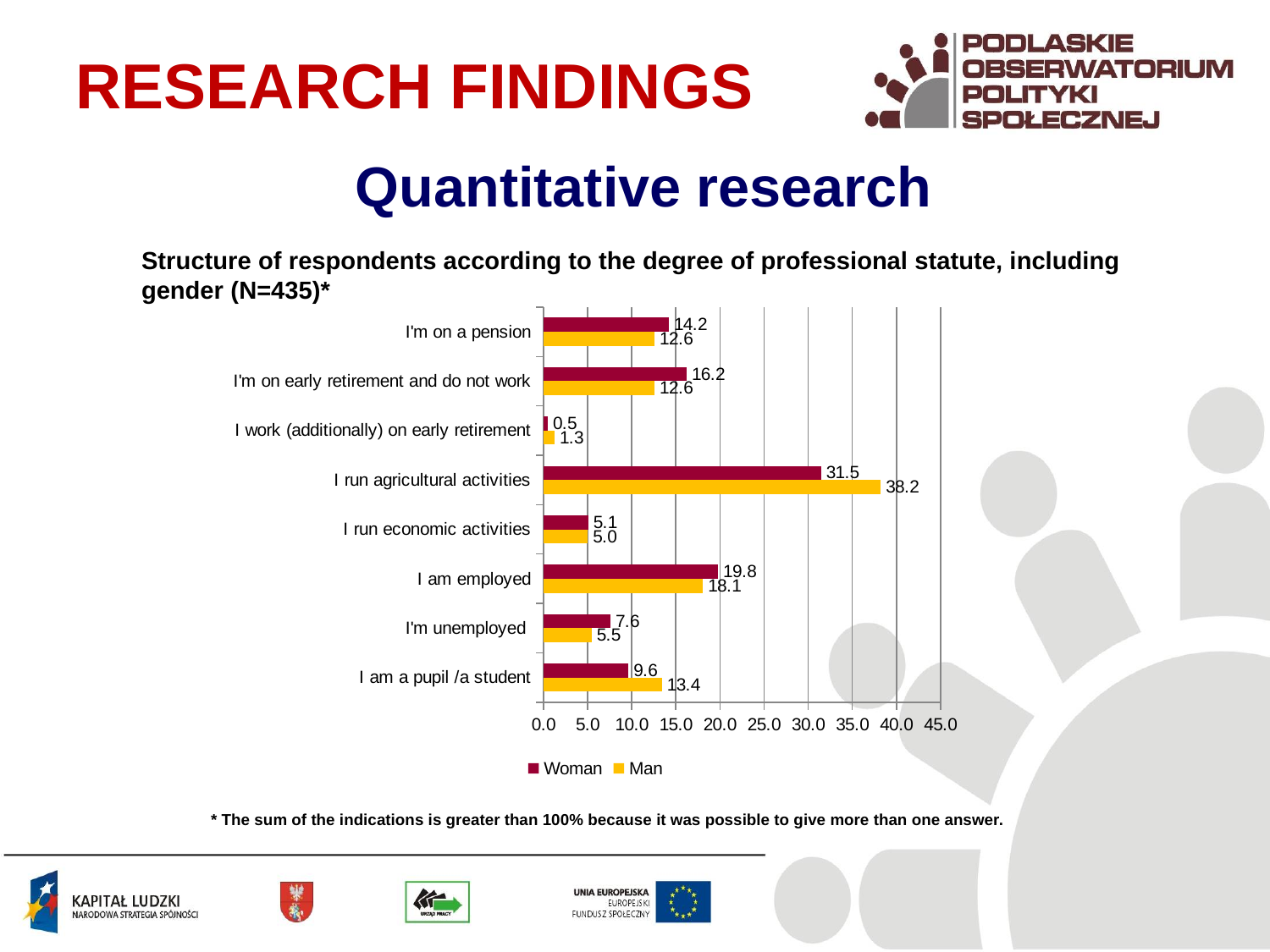
Is the Woman value for "I'm on early retirement and do not work" greater or less than 15.0? greater How many series does the legend list? 2 What is the difference between the Man and Woman values for "I run agricultural activities"? 6.7 For "I'm unemployed", which is larger, the Woman value or the Man value? Woman What is the Woman value for "I am employed"? 19.8 What kind of chart is shown on the slide? Bar chart Which colour represents the Man series in the chart? Yellow Which category has the highest Man value? I run agricultural activities Which category has the lowest Woman value? I work (additionally) on early retirement How many categories are shown on the chart? 8 What is the Woman value for "I run agricultural activities"? 31.5 What is the Man value for "I am a pupil /a student"? 13.4